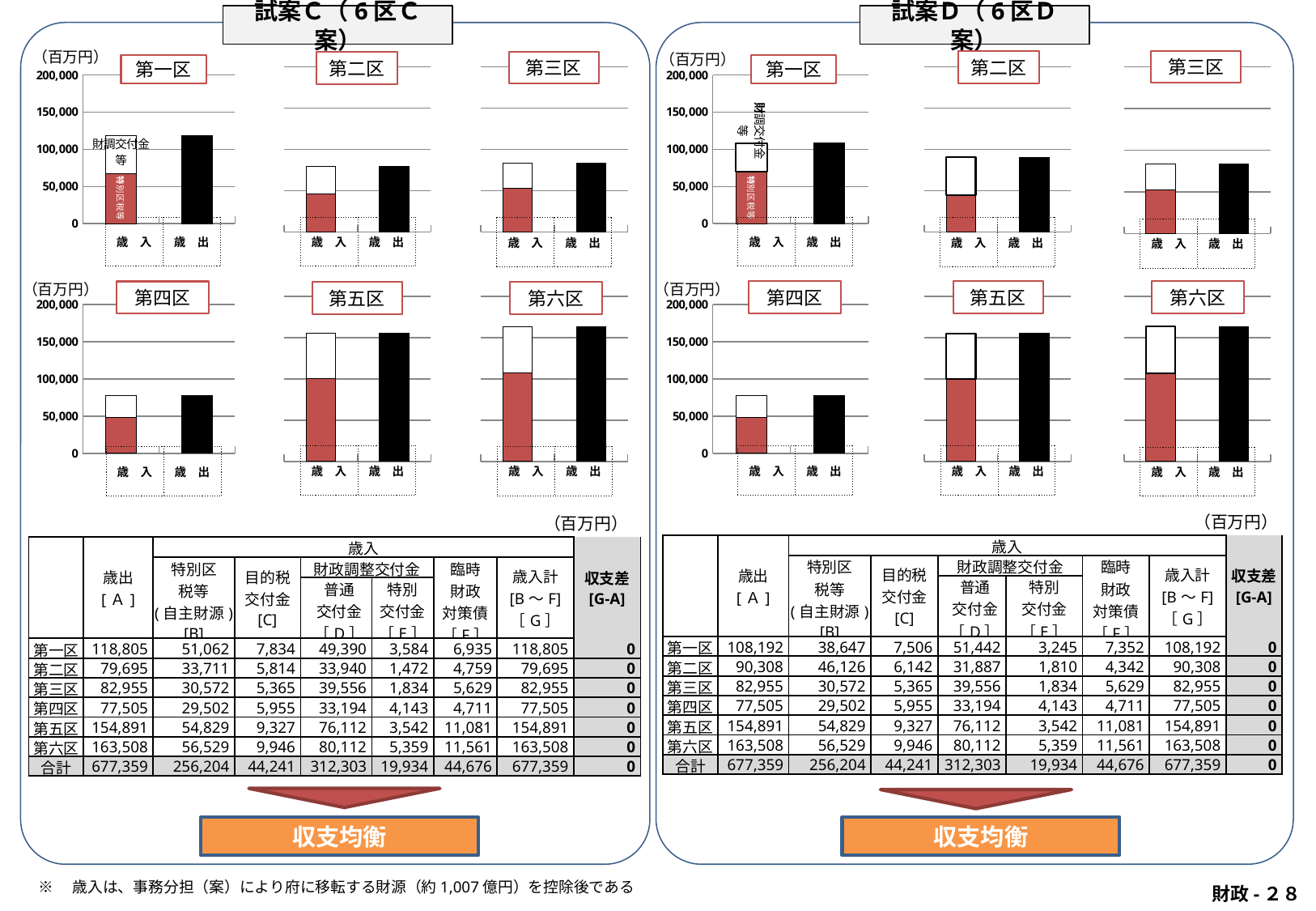
In the 試案C panel, which has the larger 歳出: 第六区 or 第四区? 第六区 In the 試案D 第一区 chart, is the 特別区税等 (red) portion of 歳入 greater or less than 50,000? less In the 試案C panel, which district has the highest 歳出? 第六区 How many district charts (第一区 to 第六区) are shown in the 試案C panel? 6 According to the 試案D table, what is the 歳出 [A] value for 第一区 (百万円)? 108,192 In the 試案D 第五区 chart, is the 歳出 value greater or less than 150,000? greater In the 歳入 bars of the charts, what colour represents 特別区税等? red According to the 試案C table, what is the 歳入計 [G] value for 第五区 (百万円)? 154,891 In the 試案C panel, what kind of chart is used for 第一区? bar chart In the 試案C 第一区 chart, is the 歳出 value greater or less than 100,000? greater In the 試案D panel, which district has the lowest 歳出? 第四区